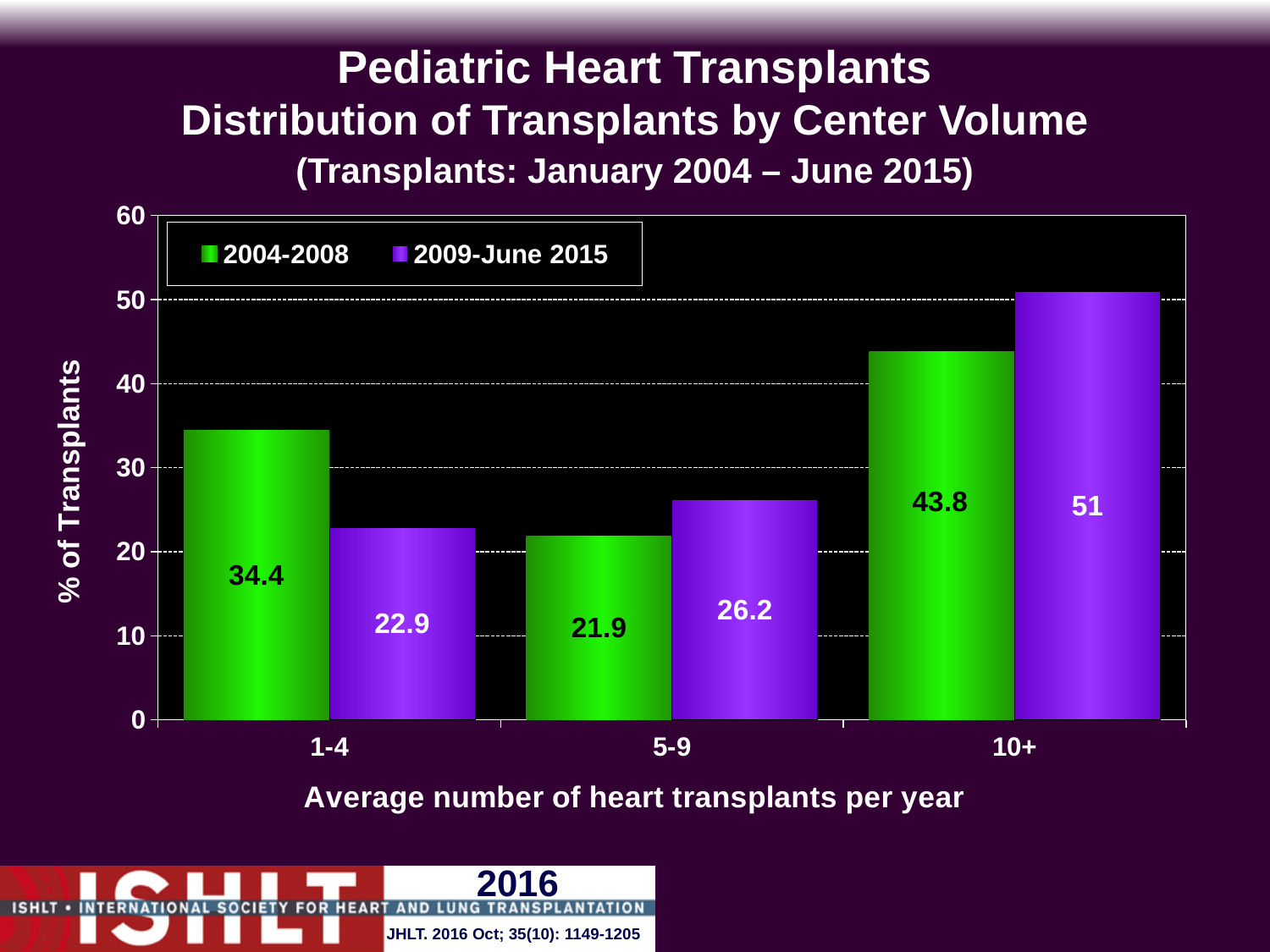
What is the difference between the 2009-June 2015 and 2004-2008 values for the 10+ category? 7.2 How many series does the legend list? 2 How many categories are shown on the x axis? 3 Which category has the lowest value in the 2009-June 2015 series? 1-4 Which category has the highest value in the 2004-2008 series? 10+ For the 1-4 category, which series has the larger value, 2004-2008 or 2009-June 2015? 2004-2008 Is the value for the 10+ category in the 2009-June 2015 series greater or less than 50? greater What is the value for the 1-4 category in the 2004-2008 series? 34.4 What kind of chart is shown on the slide? bar chart What is the value for the 5-9 category in the 2009-June 2015 series? 26.2 What is the value for the 10+ category in the 2009-June 2015 series? 51 What is the label of the y axis? % of Transplants